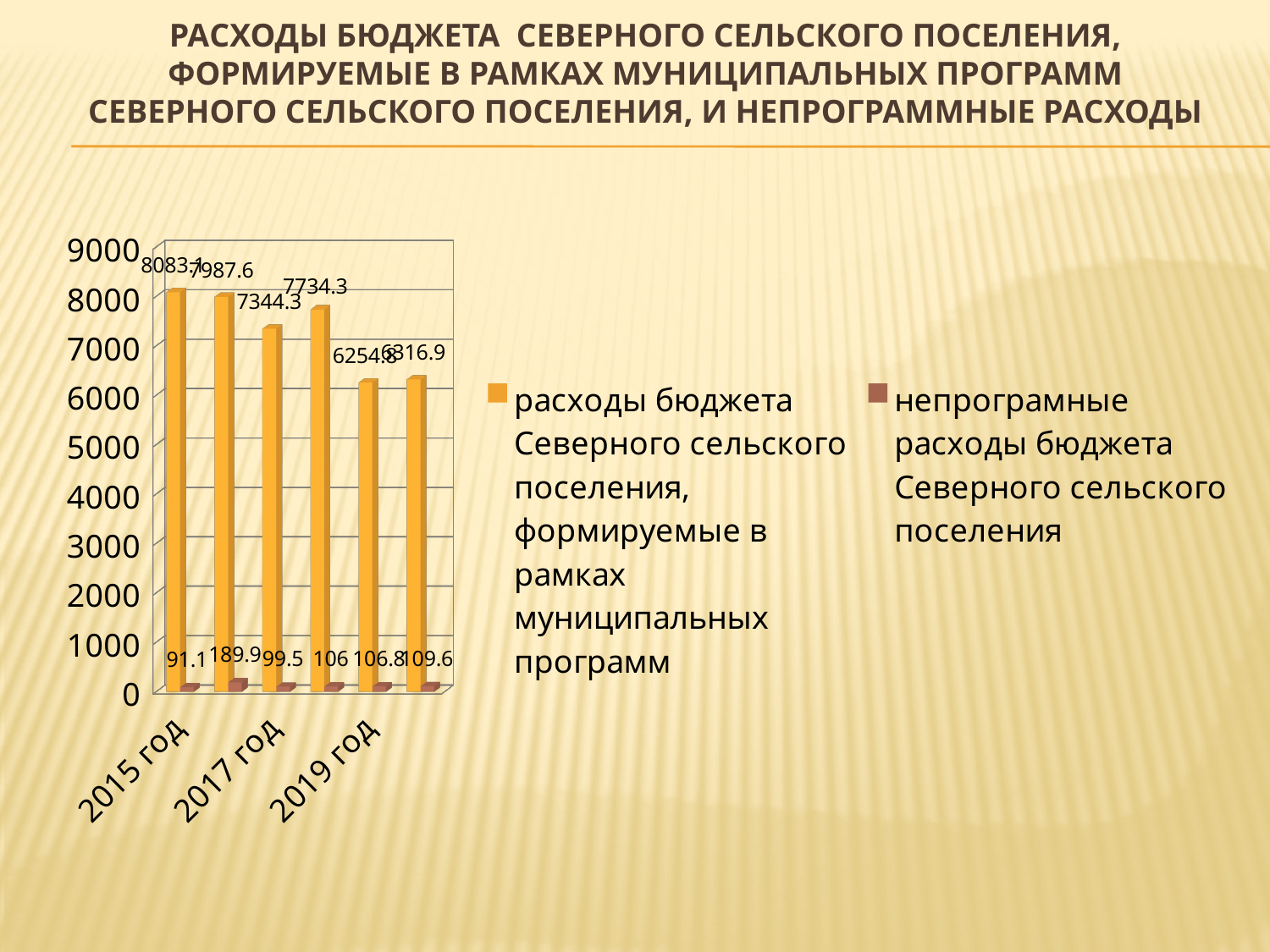
What is the value of the non-program expenses (непрограмные расходы) for 2015 год? 91.1 What is the value of the non-program expenses for 2019 год? 106.8 Which is larger: the non-program expenses for 2015 год or for 2019 год? 2019 год Which labeled year has the highest value for budget expenses formed within municipal programs? 2015 год What is the difference between the program expenses for 2015 год and 2019 год? 1828.3 What kind of chart is shown on the slide? bar chart Is the value of program expenses for 2017 год greater or less than 7000? greater How many series does the legend list? 2 Do the program expenses generally rise or fall from 2015 год to 2019 год? fall What is the difference between the program expenses for 2015 год and 2017 год? 738.8 What is the value of the budget expenses formed within municipal programs for 2017 год? 7344.3 What is the value of the budget expenses formed within municipal programs (расходы бюджета ... формируемые в рамках муниципальных программ) for 2015 год? 8083.1